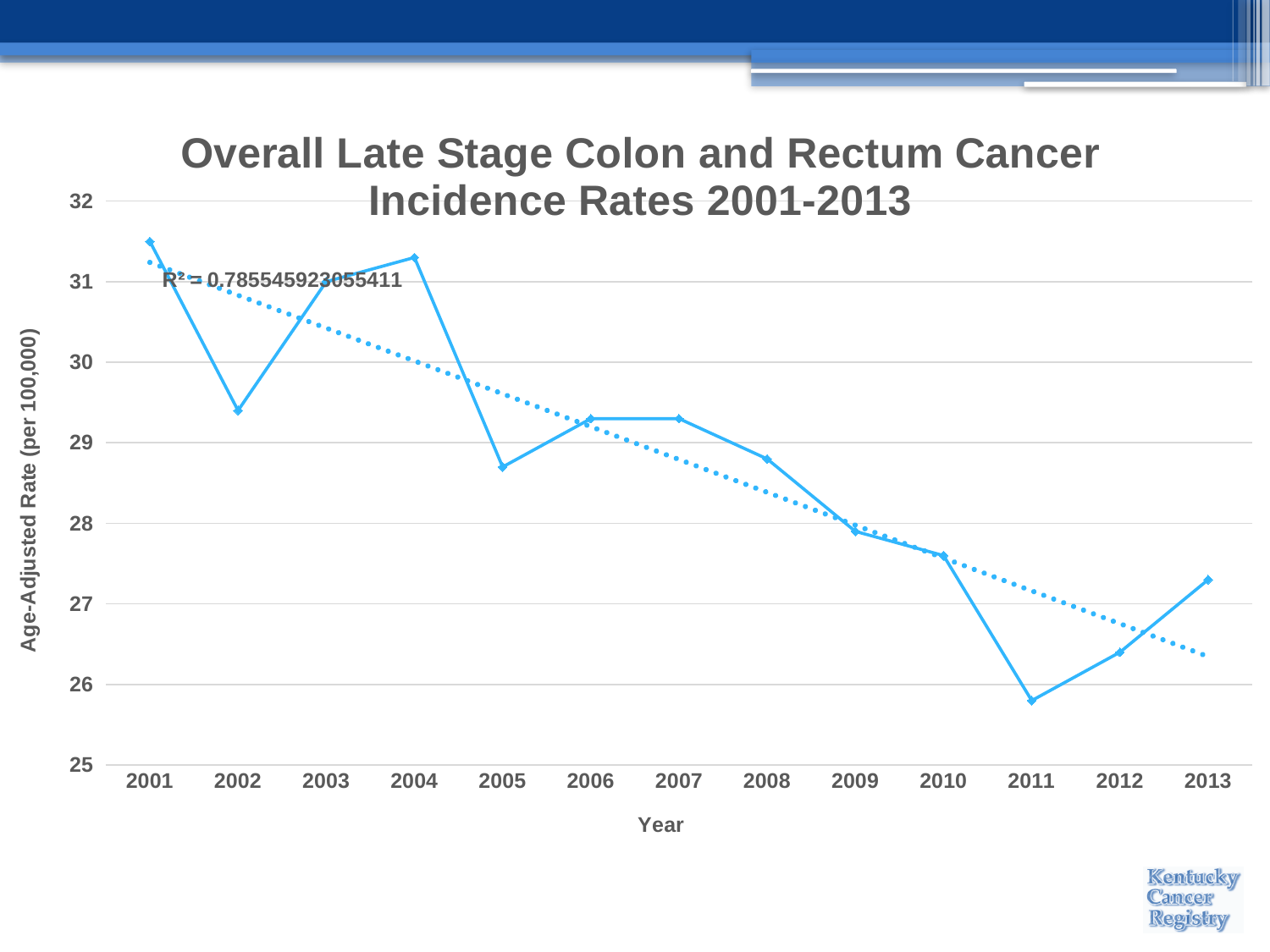
Which year has the highest late stage colon and rectum cancer incidence rate? 2001 Which year has the lowest late stage colon and rectum cancer incidence rate? 2011 Is the value for 2004 greater or less than 31? greater Which year has the larger incidence rate, 2002 or 2003? 2003 Is the value for 2013 greater or less than 27? greater How many years are plotted on the x axis? 13 Is the value for 2002 greater or less than 30? less What kind of chart is shown on the slide? Line chart Overall, do the incidence rates rise or fall from 2001 to 2013? Fall What is the label of the vertical axis? Age-Adjusted Rate (per 100,000) What R² value is printed on the chart for the trend line? R² = 0.785545923055411